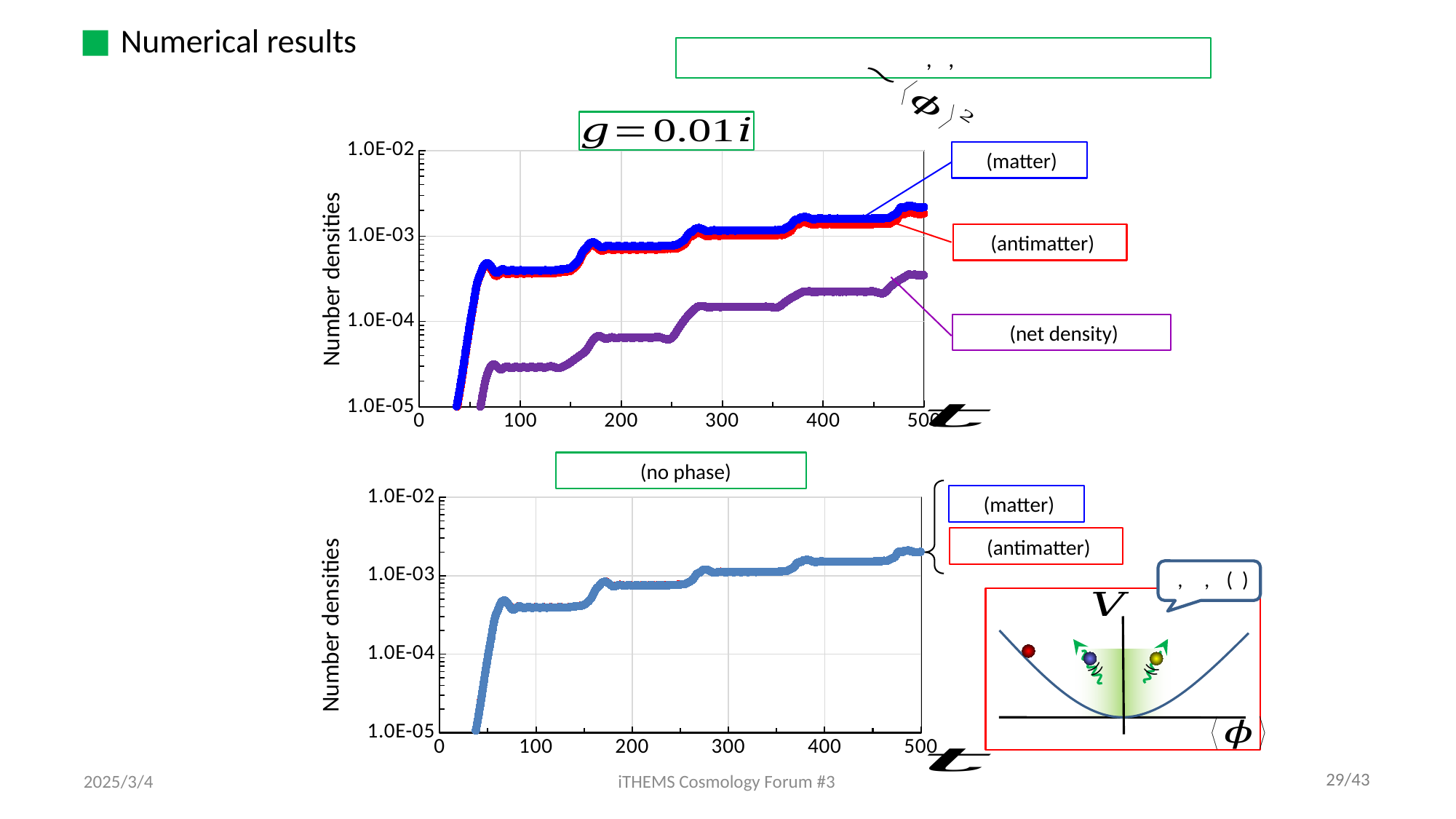
In the bottom chart labelled (no phase), what is the highest value shown on the x axis? 500 In the top chart titled g = 0.01i, is the matter density at t = 400 greater or less than 1.0E-03? greater In the bottom chart labelled (no phase), is the number density at t = 100 greater or less than 1.0E-03? less In the top chart titled g = 0.01i, do the number densities generally rise or fall as t increases? rise In the top chart titled g = 0.01i, is the net density at t = 300 greater or less than 1.0E-04? greater In the top chart titled g = 0.01i, how many series are labelled? 3 In the top chart titled g = 0.01i, at t = 300, which is larger: the matter density or the net density? matter density In the top chart titled g = 0.01i, what is the label on the y axis? Number densities In the top chart titled g = 0.01i, which series is drawn in purple? (net density) In the bottom chart labelled (no phase), how many series are labelled? 2